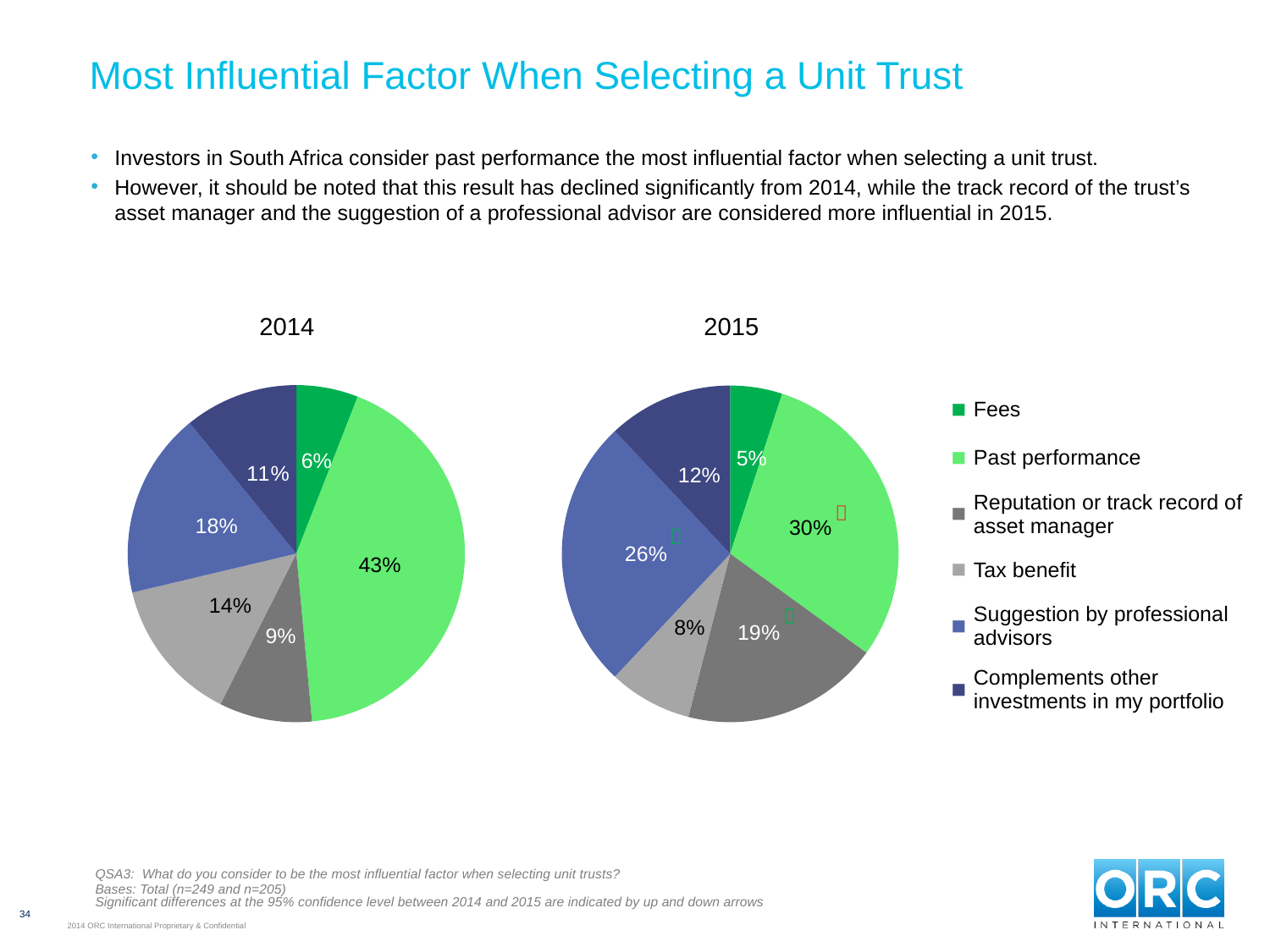
In the 2014 pie chart, what is the difference between Suggestion by professional advisors and Complements other investments in my portfolio? 7 percentage points In the 2015 pie chart, which is larger: Suggestion by professional advisors or Reputation or track record of asset manager? Suggestion by professional advisors What type of chart is used for the 2014 and 2015 data? Pie chart In the 2014 pie chart, which category has the smallest share? Fees In the 2015 pie chart, what share is Reputation or track record of asset manager? 19% How many categories does the legend list? 6 In the 2015 pie chart, what share is Suggestion by professional advisors? 26% In the 2014 pie chart, what share is Tax benefit? 14% What is the difference between the Past performance share in the 2014 chart and in the 2015 chart? 13 percentage points In the 2014 pie chart, what share is Past performance? 43% In the 2015 pie chart, which category has the largest share? Past performance How many slices does the 2015 pie chart have? 6